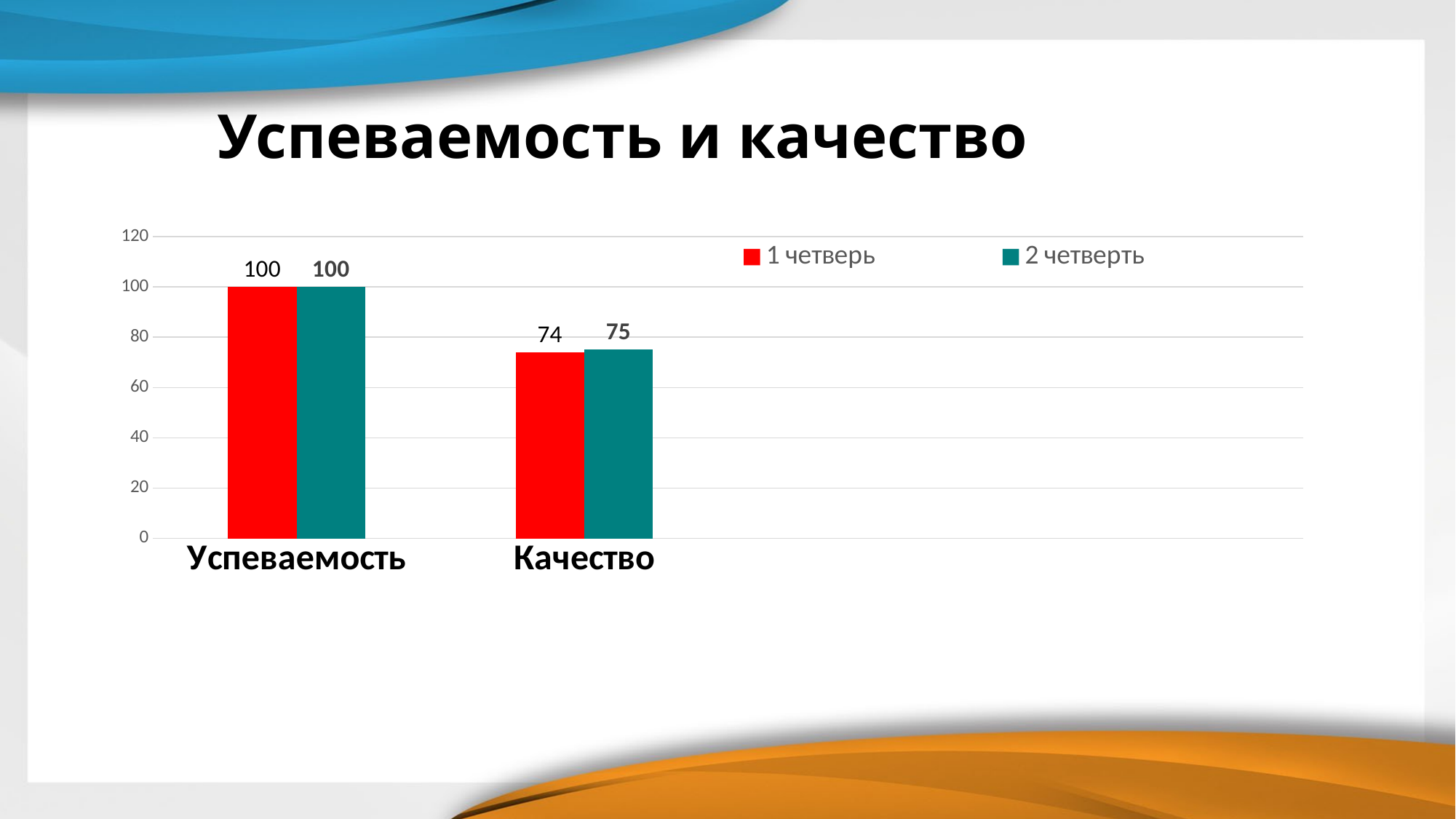
What is the value for Качество in the 1 четверть series? 74 Which category has the highest value in the 2 четверть series? Успеваемость How many categories are shown on the x axis? 2 What kind of chart is shown on the slide? Bar chart What is the value for Успеваемость in the 2 четверть series? 100 Which category has the lowest value in the 1 четверть series? Качество How many series does the legend list? 2 What is the difference between the 2 четверть and 1 четверть values for Качество? 1 What is the value for Качество in the 2 четверть series? 75 What is the value for Успеваемость in the 1 четверть series? 100 What is the difference between the 1 четверть values for Успеваемость and Качество? 26 Which is larger: the 1 четверть value for Успеваемость or the 1 четверть value for Качество? Успеваемость